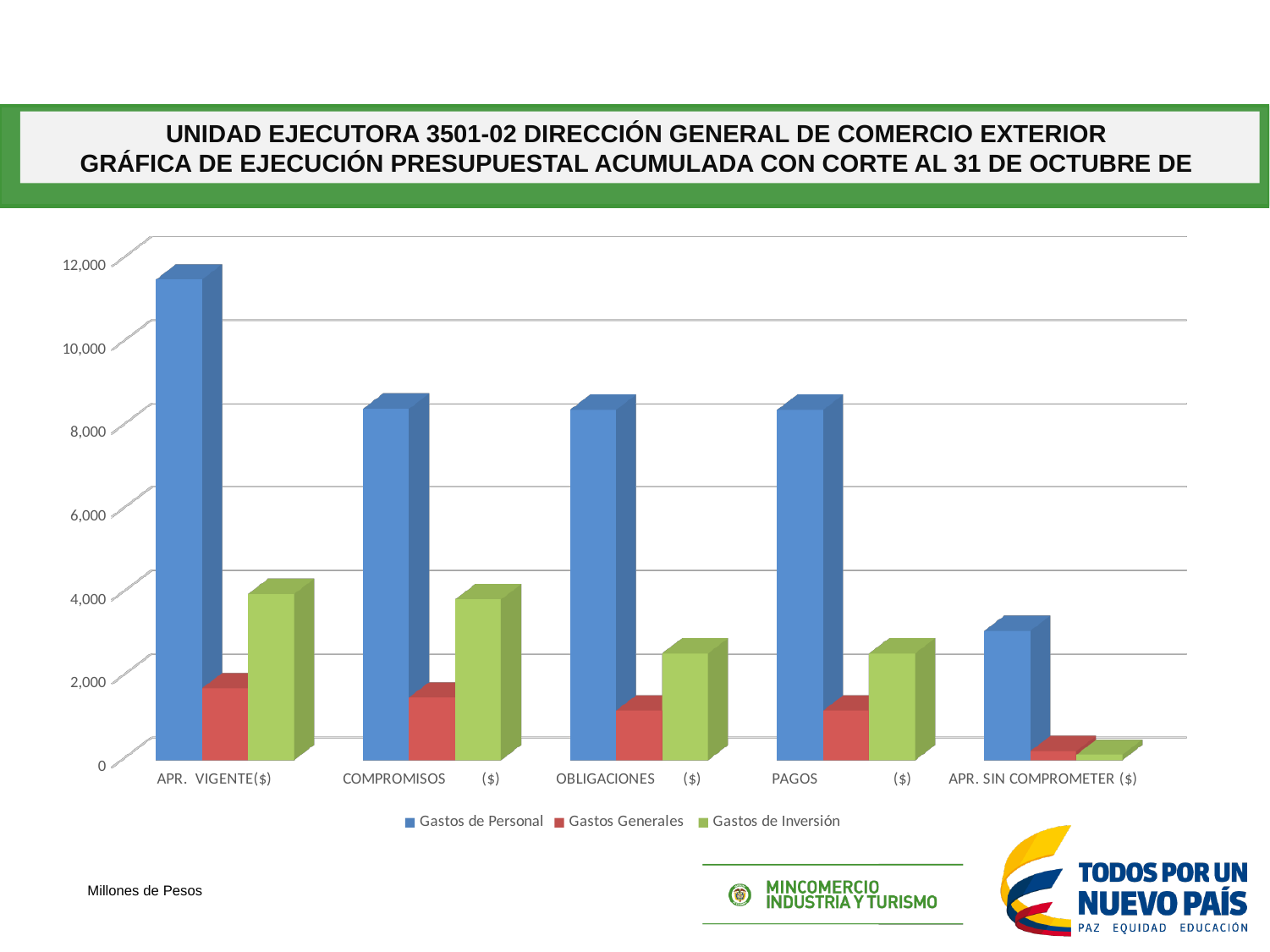
Is the value of Gastos de Personal for APR. VIGENTE($) greater or less than 10,000? greater Is the value of Gastos de Personal for APR. SIN COMPROMETER ($) greater or less than 4,000? less Is the value of Gastos de Personal for PAGOS ($) greater or less than 6,000? greater Which category has the highest value for Gastos de Personal? APR. VIGENTE($) How many series does the legend list? 3 Do the values for Gastos de Inversión rise or fall from APR. VIGENTE($) to APR. SIN COMPROMETER ($)? fall For APR. VIGENTE($), which is larger: Gastos Generales or Gastos de Inversión? Gastos de Inversión How many categories are shown on the x axis? 5 Which category has the lowest value for Gastos de Personal? APR. SIN COMPROMETER ($) What kind of chart is shown on the slide? Bar chart What colour represents Gastos de Inversión in the legend? Green